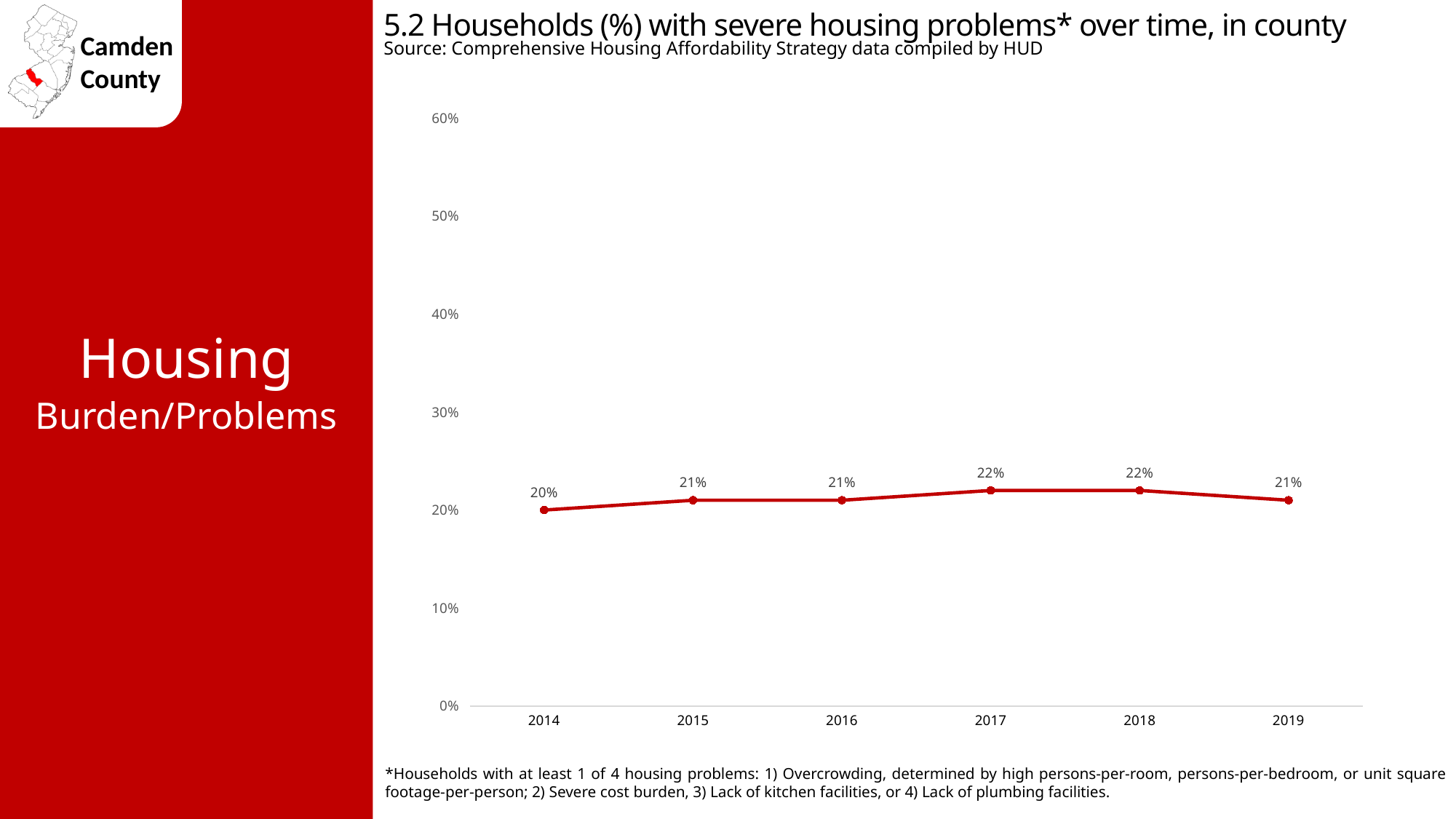
Did the value rise or fall from 2018 to 2019? Fall Is the value for 2015 larger than the value for 2014? Yes What kind of chart is shown on the slide? Line chart Which year has the lowest percentage of households with severe housing problems? 2014 What is the title of the chart? 5.2 Households (%) with severe housing problems* over time, in county What is the difference between the 2018 value and the 2014 value? 2% How many years are plotted on the chart? 6 What percentage of households had severe housing problems in 2014? 20% What is the value shown for 2017? 22% Is the value for 2017 greater or less than 30%? less What is the value shown for 2019? 21% What is the highest value labelled on the y axis? 60%